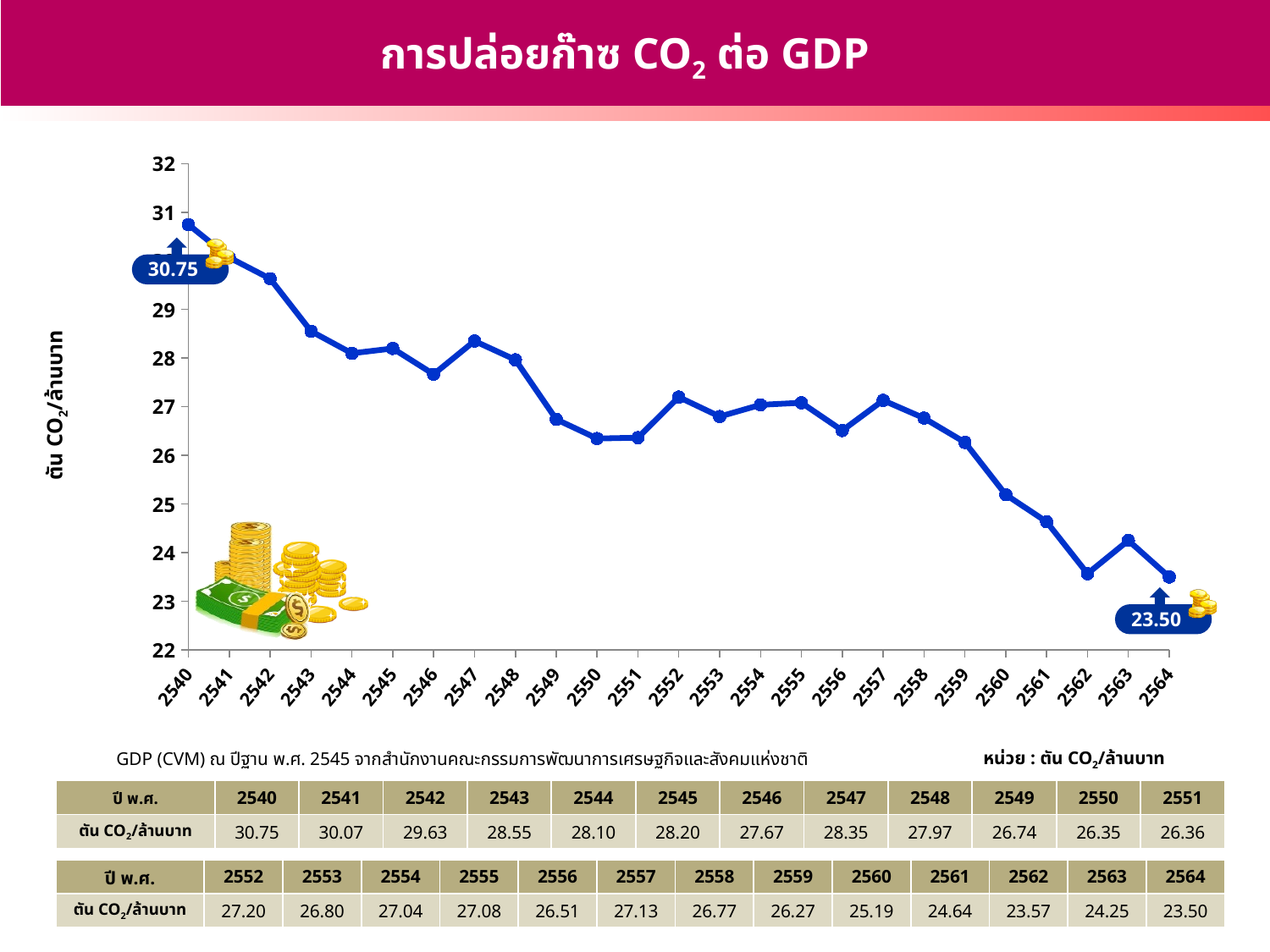
Do the values generally rise or fall from 2540 to 2564? fall What is the difference between the values for 2563 and 2562? 0.68 Which year has the lowest value? 2564 What is the difference between the values for 2540 and 2564? 7.25 What is the value for the year 2540? 30.75 What is the value for the year 2564? 23.50 How many years are plotted on the chart? 25 What is the value for the year 2550? 26.35 Which year has the larger value, 2546 or 2547? 2547 Is the value for 2560 greater or less than 26? less What kind of chart is shown on the slide? line chart Which year has the highest value? 2540